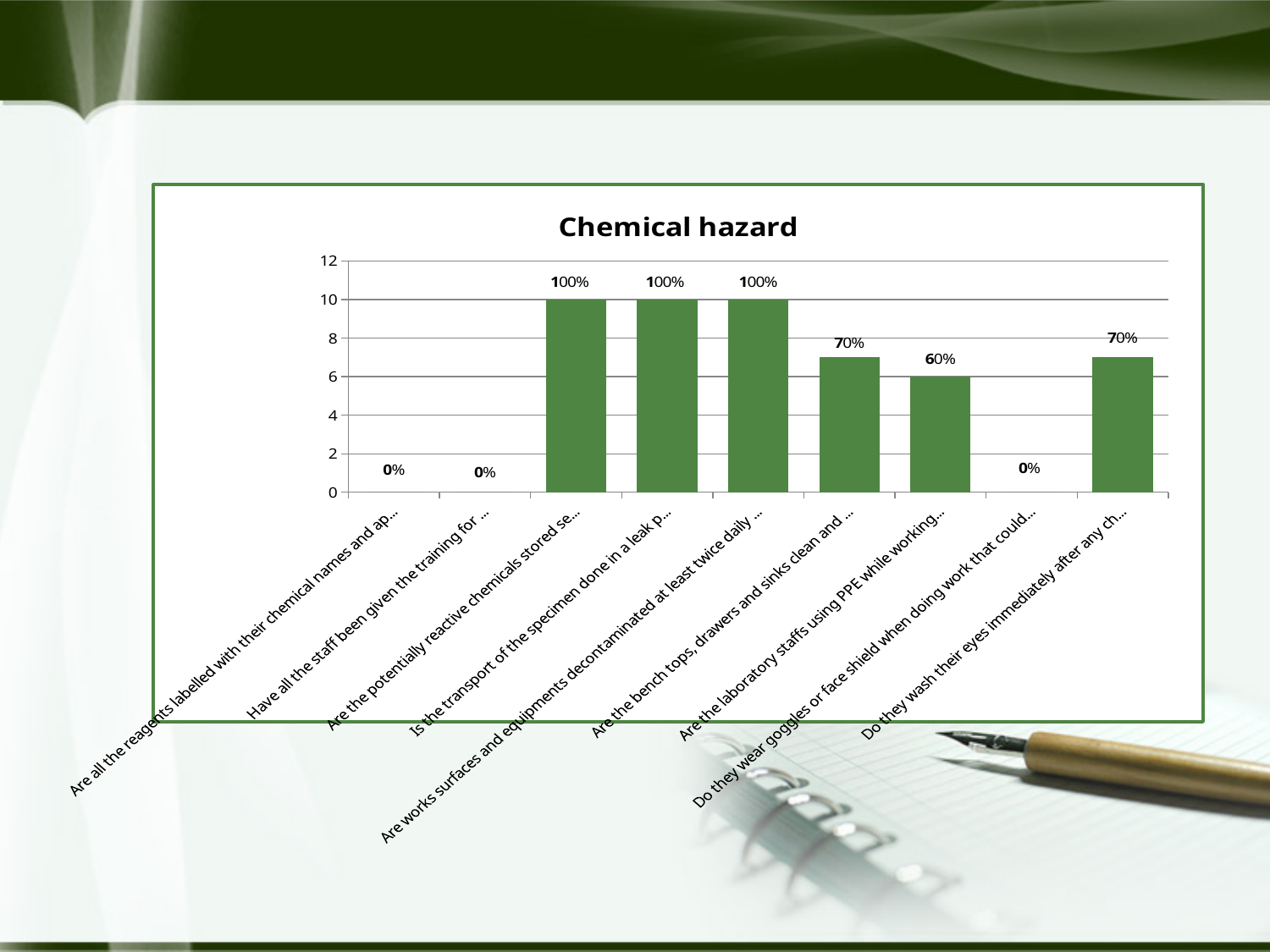
What is the data label for the category beginning "Is the transport of the specimen done in a leak"? 100% How many categories have a data label of 100%? 3 What is the data label for the category beginning "Do they wear goggles or face shield"? 0% What is the data label for the category beginning "Are the bench tops, drawers and sinks clean"? 70% What is the difference between the data labels for the category beginning "Are the bench tops, drawers and sinks clean" and the category beginning "Are the laboratory staffs using PPE"? 10% What kind of chart is shown on the slide? bar chart How many categories have a data label of 0%? 3 How many categories (bars) does the chart have? 9 Which is larger: the value for the category beginning "Are the laboratory staffs using PPE" or the category beginning "Do they wash their eyes immediately"? Do they wash their eyes immediately What is the data label for the category beginning "Do they wash their eyes immediately"? 70% What is the title of the chart? Chemical hazard What is the data label for the category beginning "Are the laboratory staffs using PPE while working"? 60%